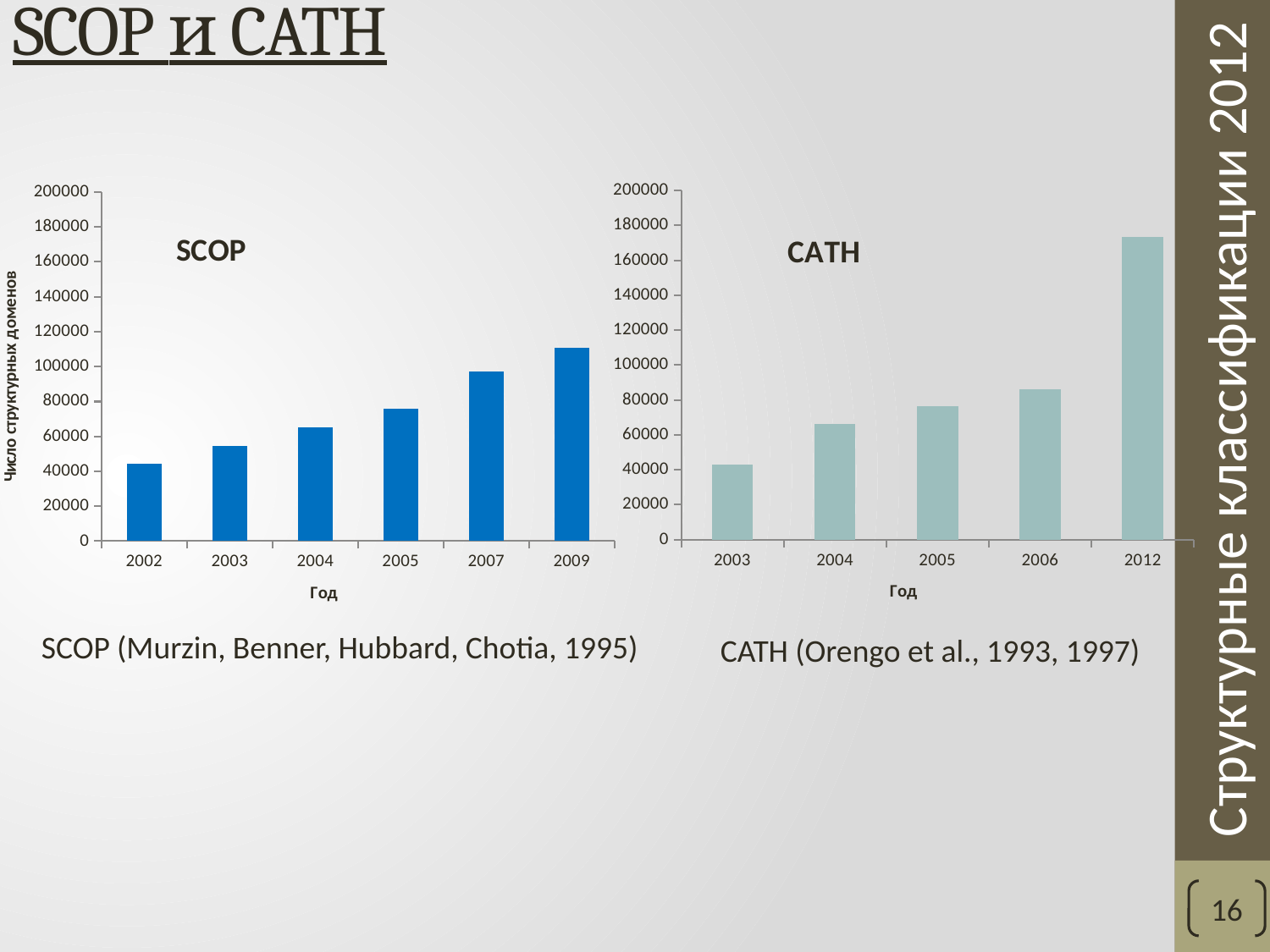
How many years are shown on the SCOP chart? 6 On the CATH chart, is the value for 2003 greater or less than 60000? less On the SCOP chart, which year has the lowest number of structural domains? 2002 How many years are shown on the CATH chart? 5 On the CATH chart, which year has the highest value? 2012 On the SCOP chart, which year has the highest number of structural domains? 2009 On the CATH chart, which is larger: the value for 2004 or the value for 2006? 2006 On the CATH chart, which year has the lowest value? 2003 What kind of chart is the SCOP chart? bar chart On the CATH chart, is the value for 2012 greater or less than 160000? greater On the SCOP chart, is the value for 2009 greater or less than 100000? greater On the SCOP chart, do the values rise or fall from 2002 to 2009? rise